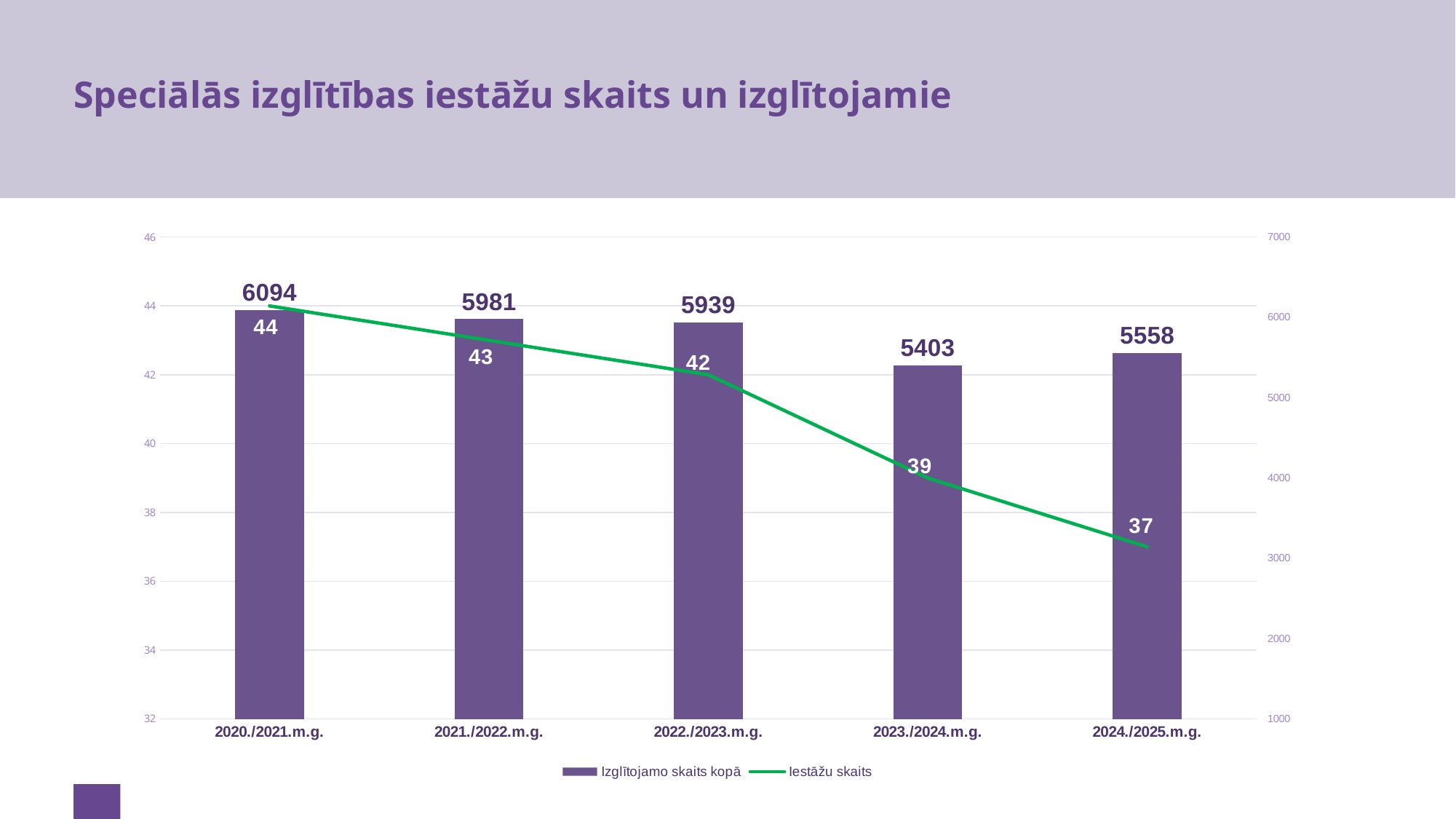
Which school year has the lowest Iestāžu skaits? 2024./2025.m.g. Which is larger, Izglītojamo skaits kopā for 2023./2024.m.g. or for 2024./2025.m.g.? 2024./2025.m.g. Does Iestāžu skaits rise or fall across the school years from 2020./2021.m.g. to 2024./2025.m.g.? fall What is the difference in Izglītojamo skaits kopā between 2020./2021.m.g. and 2024./2025.m.g.? 536 How many school years are shown on the x axis? 5 Which school year has the lowest Izglītojamo skaits kopā? 2023./2024.m.g. What is the value of Iestāžu skaits for 2023./2024.m.g.? 39 What is the difference in Iestāžu skaits between 2020./2021.m.g. and 2024./2025.m.g.? 7 What is the value of Izglītojamo skaits kopā for 2020./2021.m.g.? 6094 Which school year has the highest Izglītojamo skaits kopā? 2020./2021.m.g. How many series does the legend list? 2 What is the value of Izglītojamo skaits kopā for 2024./2025.m.g.? 5558